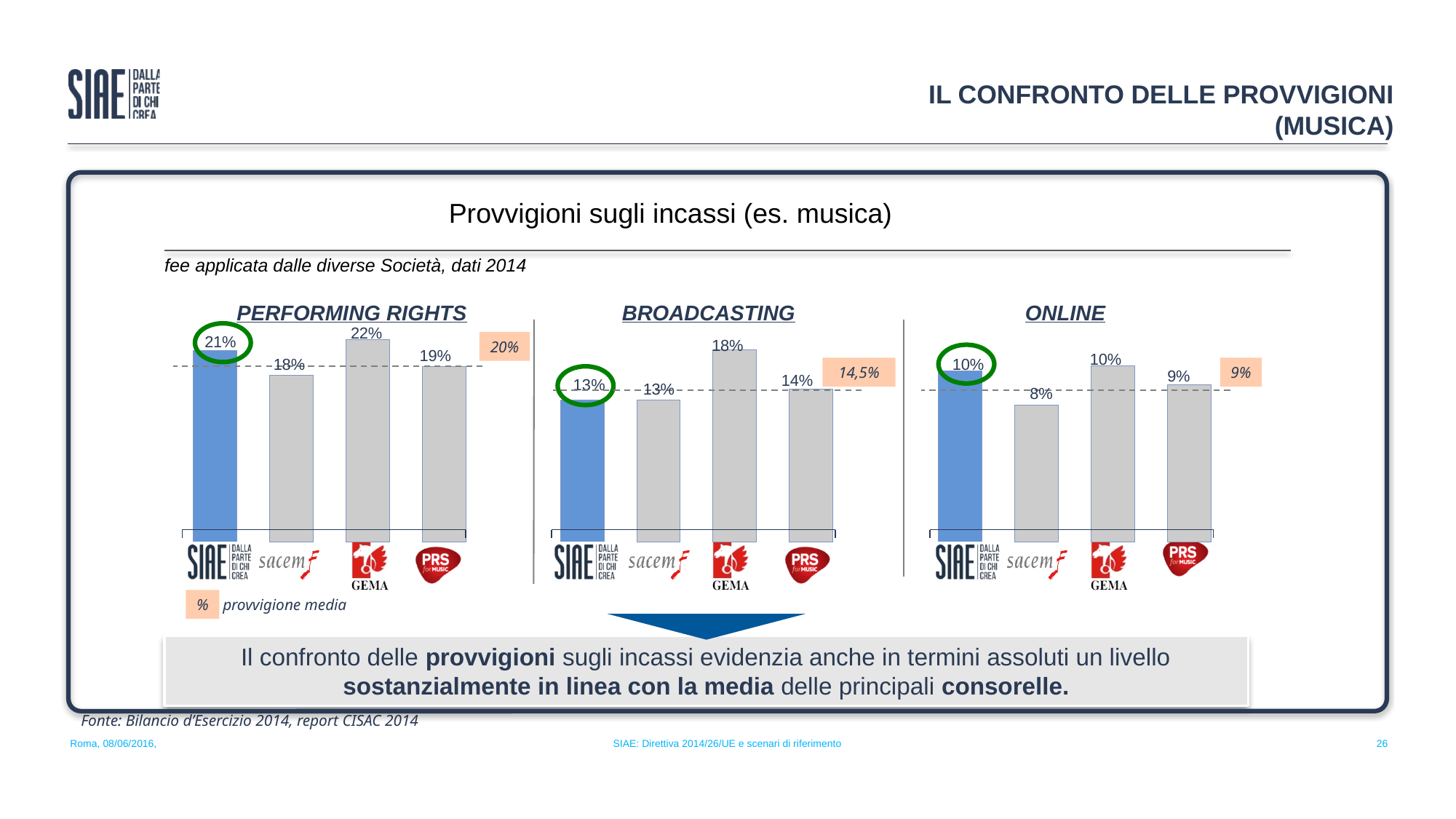
In the PERFORMING RIGHTS chart, what is the average commission (provvigione media) shown? 20% In the PERFORMING RIGHTS chart, which society has the lowest value? SACEM In the PERFORMING RIGHTS chart, what is the value for SIAE? 21% In the ONLINE chart, what is the value for SACEM? 8% What type of chart is used in the BROADCASTING section? Bar chart In the ONLINE chart, which is larger, the value for PRS or the value for SACEM? PRS In the PERFORMING RIGHTS chart, which society has the highest value? GEMA What is the title of the chart area on the slide? Provvigioni sugli incassi (es. musica) In the BROADCASTING chart, what is the average commission (provvigione media) shown? 14,5% In the BROADCASTING chart, what is the difference between GEMA and SIAE? 5% In the BROADCASTING chart, what is the value for GEMA? 18% How many societies are compared in the ONLINE chart? 4